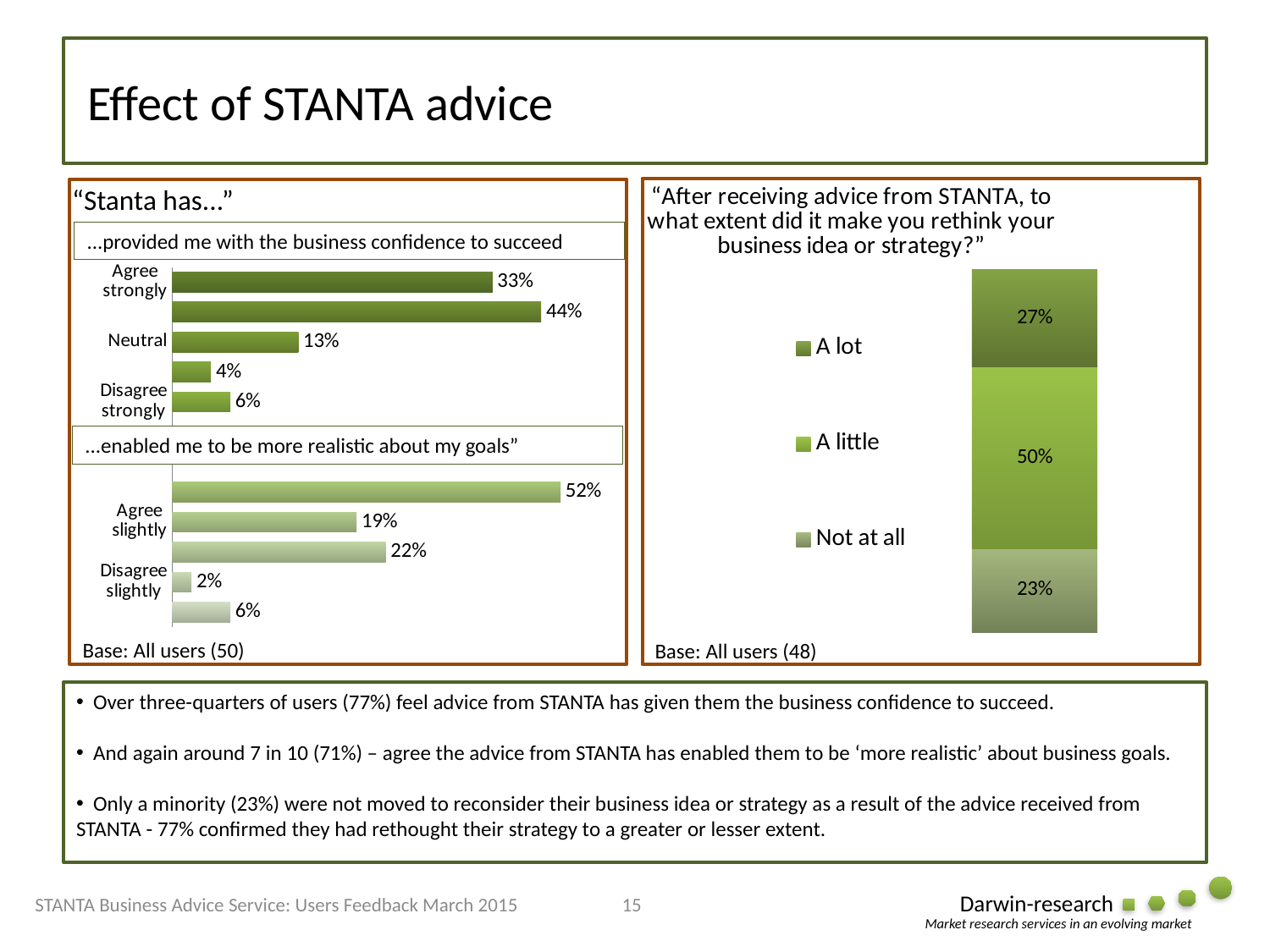
In the '...provided me with the business confidence to succeed' chart, what is the value for Disagree strongly? 6% How many entries does the legend of the chart on the right list? 3 In the '...enabled me to be more realistic about my goals' chart, what is the value for Agree slightly? 19% What kind of chart is the chart on the right about rethinking business idea or strategy? Stacked bar chart In the chart on the right about rethinking business idea or strategy, what percentage answered 'A lot'? 27% In the '...provided me with the business confidence to succeed' chart, what percentage of users agree strongly? 33% In the '...provided me with the business confidence to succeed' chart, which is larger: Agree strongly or Neutral? Agree strongly In the '...enabled me to be more realistic about my goals' chart, what is the value for Disagree slightly? 2% In the chart on the right about rethinking business idea or strategy, what percentage answered 'Not at all'? 23% In the '...provided me with the business confidence to succeed' chart, what is the value for Neutral? 13% In the chart on the right about rethinking business idea or strategy, what is the difference between 'A little' and 'A lot'? 23 percentage points In the chart on the right about rethinking business idea or strategy, which response has the largest share? A little